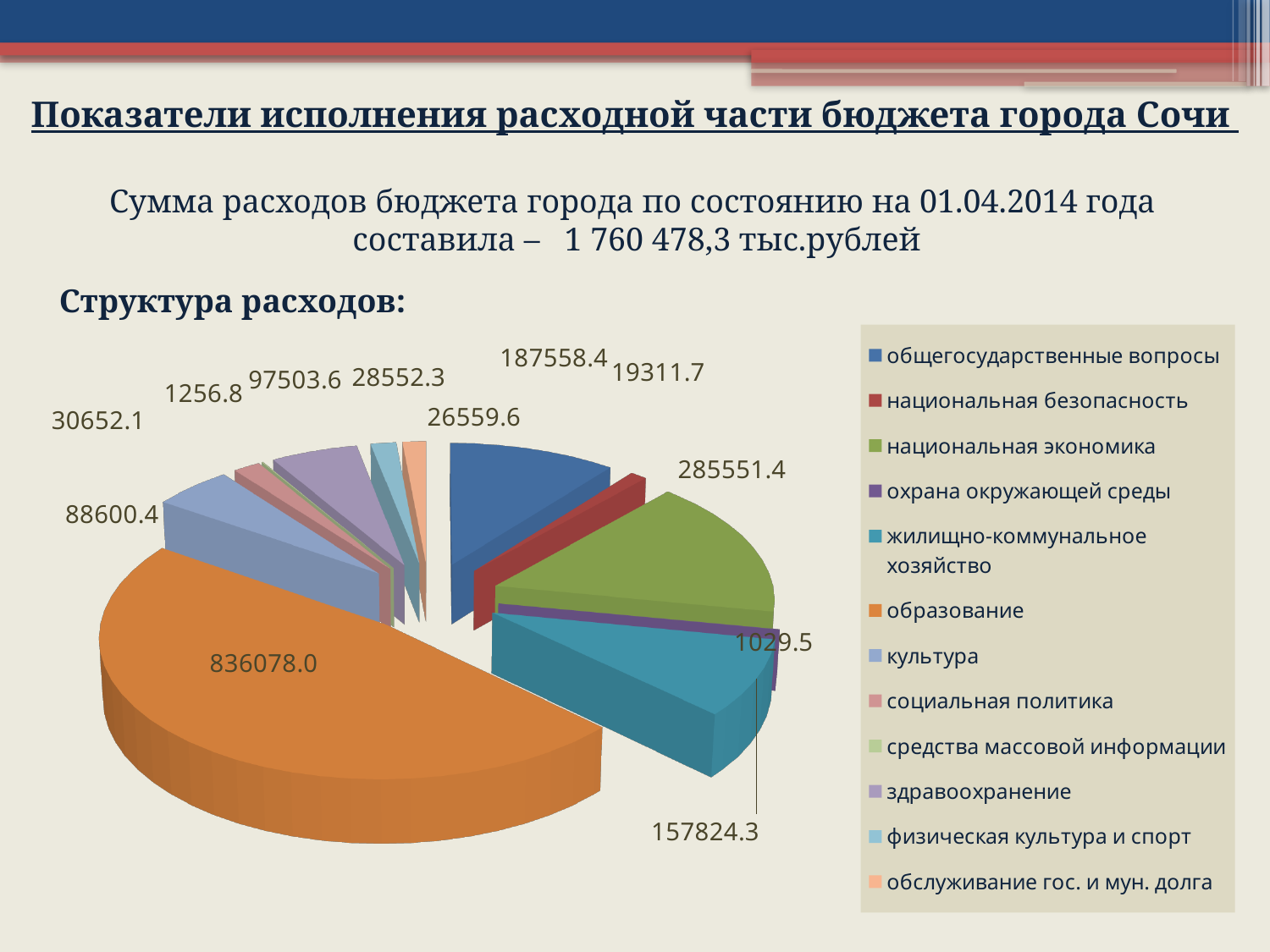
What is the value for образование in the pie chart? 836078.0 Which category has the largest slice in the pie chart? образование Which category has the smallest value in the pie chart? охрана окружающей среды What is the difference between the values for образование and национальная экономика? 550526.6 What colour is the slice for образование in the pie chart? orange How many categories does the legend of the pie chart list? 12 Which is larger, the value for общегосударственные вопросы or the value for жилищно-коммунальное хозяйство? общегосударственные вопросы What is the value for национальная экономика in the pie chart? 285551.4 What kind of chart is shown on the slide? pie chart What is the value for общегосударственные вопросы in the pie chart? 187558.4 What is the value for культура in the pie chart? 88600.4 What is the value for жилищно-коммунальное хозяйство in the pie chart? 157824.3